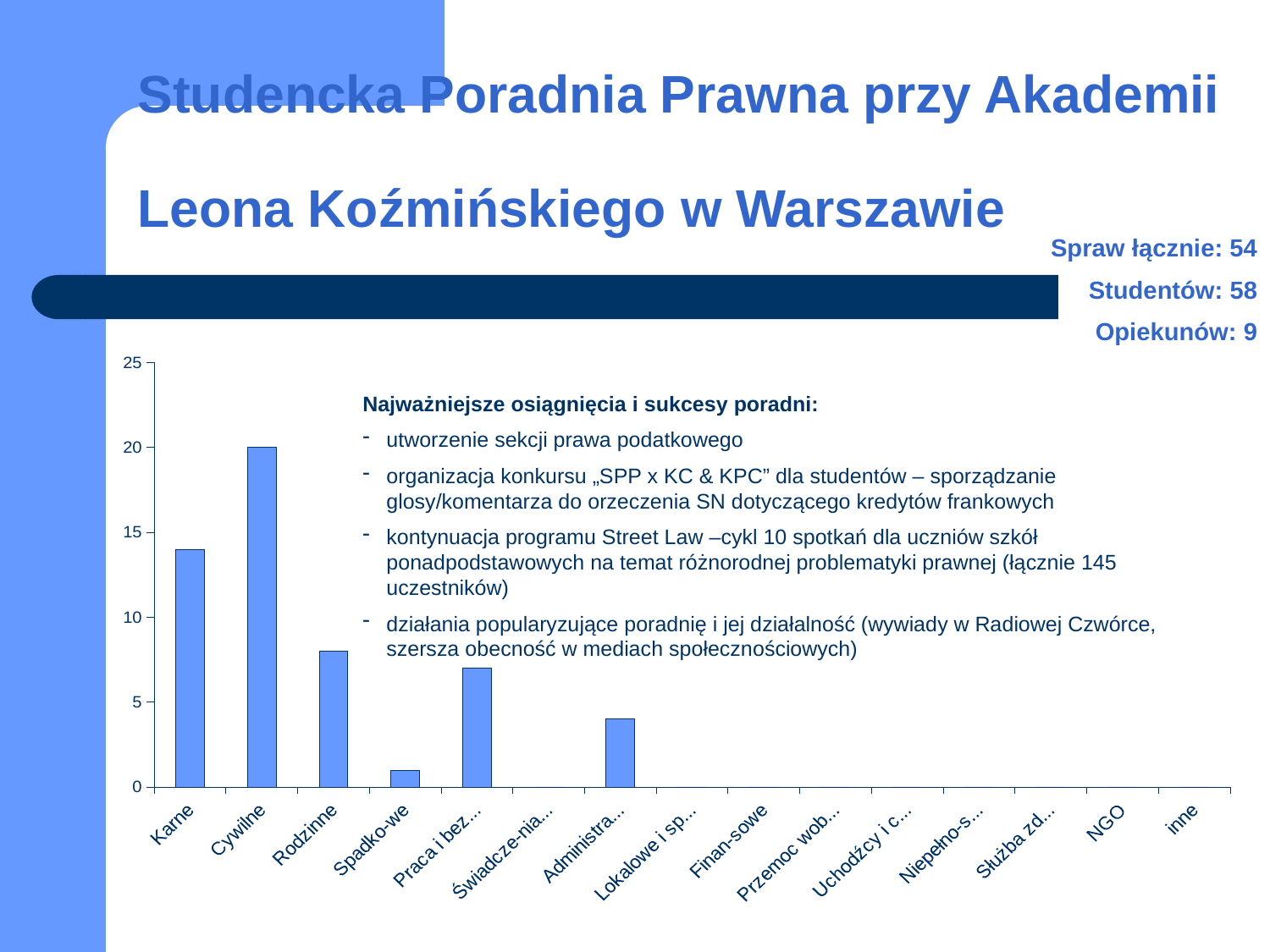
Which is larger, the value for Praca i bez... or the value for Administra...? Praca i bez... Is the value for Karne greater or less than 15? less What kind of chart is shown on the slide? bar chart Is the value for Rodzinne greater or less than 10? less How many categories are shown on the x axis of the chart? 15 What is the highest value shown on the y axis of the chart? 25 Which is larger, the value for Karne or the value for Rodzinne? Karne Is the value for Administra... greater or less than 5? less Which category has the highest bar in the chart? Cywilne What is the value for Cywilne in the chart? 20